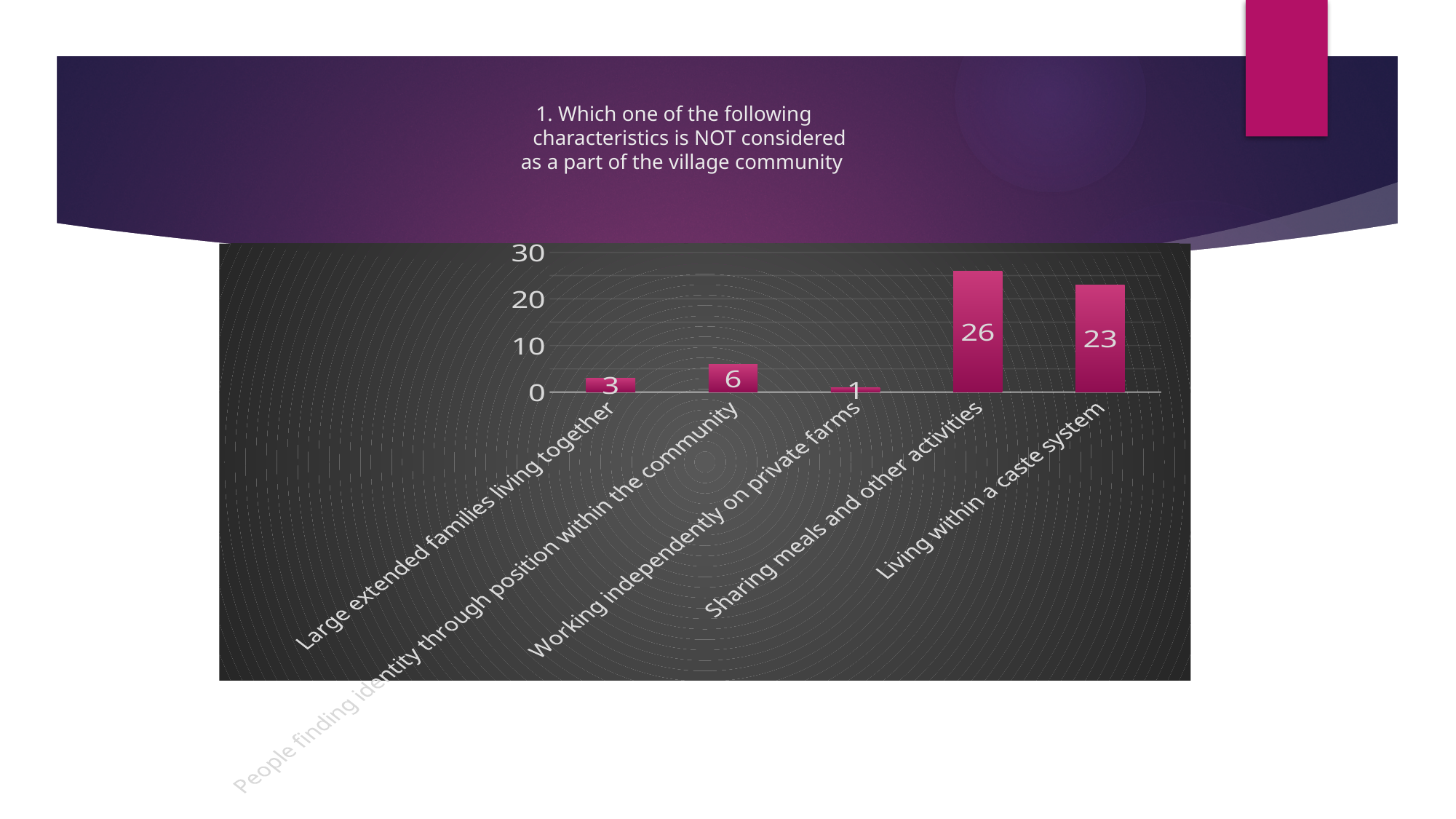
Which category has the lowest value? Working independently on private farms Which category has the highest value? Sharing meals and other activities What is the value for "Large extended families living together"? 3 What is the difference between the values for "Sharing meals and other activities" and "Living within a caste system"? 3 What kind of chart is shown on the slide? bar chart What is the title of the chart? 1. Which one of the following characteristics is NOT considered as a part of the village community What is the value for "Living within a caste system"? 23 Is the value for "Living within a caste system" greater or less than 20? greater What is the value for "Working independently on private farms"? 1 How many categories are shown on the chart? 5 What is the value for "Sharing meals and other activities"? 26 Which is larger: the value for "People finding identity through position within the community" or the value for "Large extended families living together"? People finding identity through position within the community